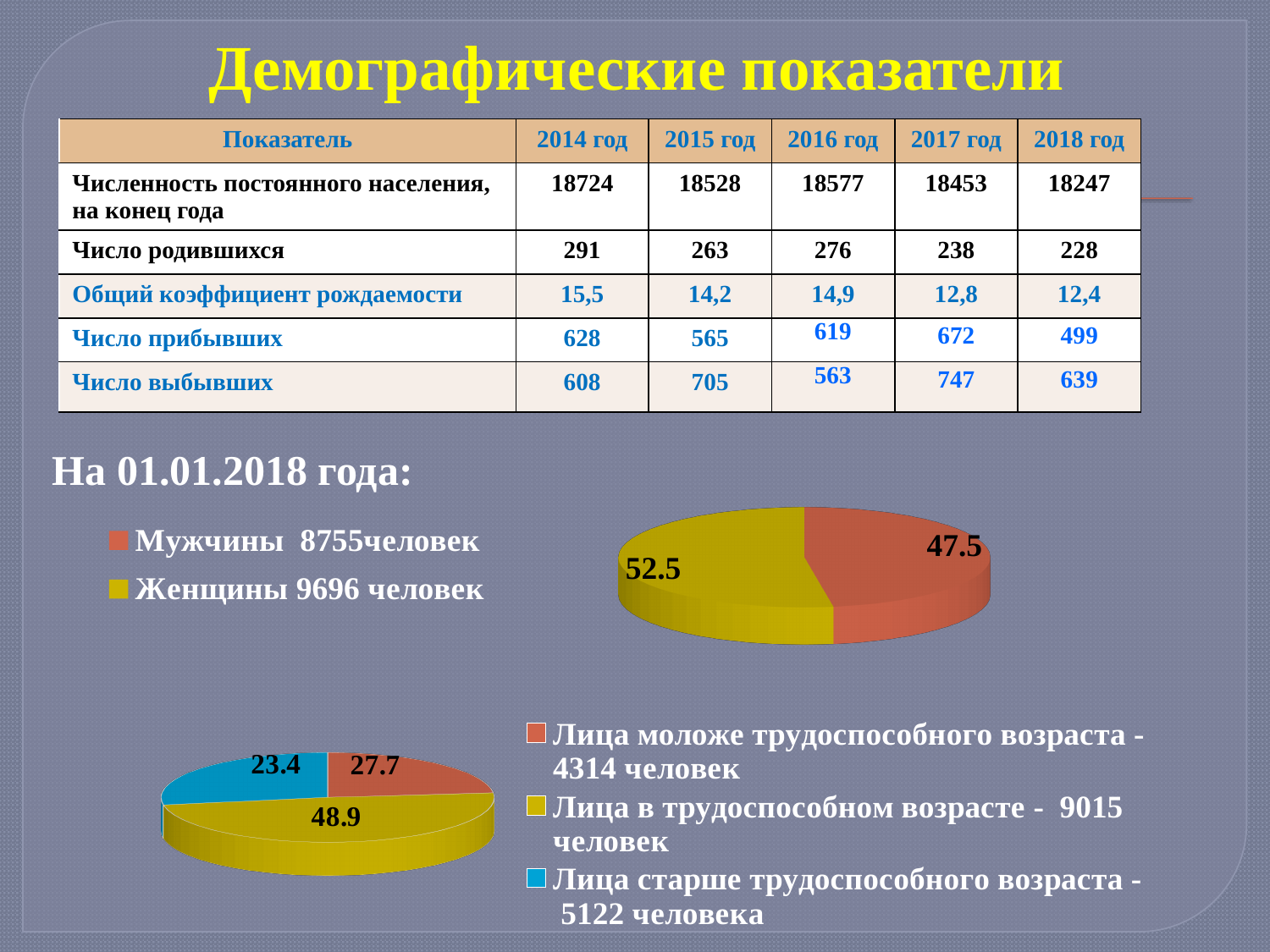
In the upper pie chart, which slice is larger, Мужчины or Женщины? Женщины In the lower pie chart, which category has the largest slice? Лица в трудоспособном возрасте In the lower pie chart, what value is shown for Лица моложе трудоспособного возраста? 27.7 In the upper pie chart, what value is shown for the Мужчины slice? 47.5 In the lower pie chart, what value is shown for Лица старше трудоспособного возраста? 23.4 In the upper pie chart, what value is shown for the Женщины slice? 52.5 In the upper pie chart, what is the difference between the Женщины and Мужчины values? 5 In the lower pie chart, what value is shown for Лица в трудоспособном возрасте? 48.9 In the lower pie chart, which category has the smallest slice? Лица старше трудоспособного возраста How many entries does the legend of the upper pie chart list? 2 What kind of chart is the upper chart on the right of the slide? pie chart How many slices does the lower pie chart have? 3